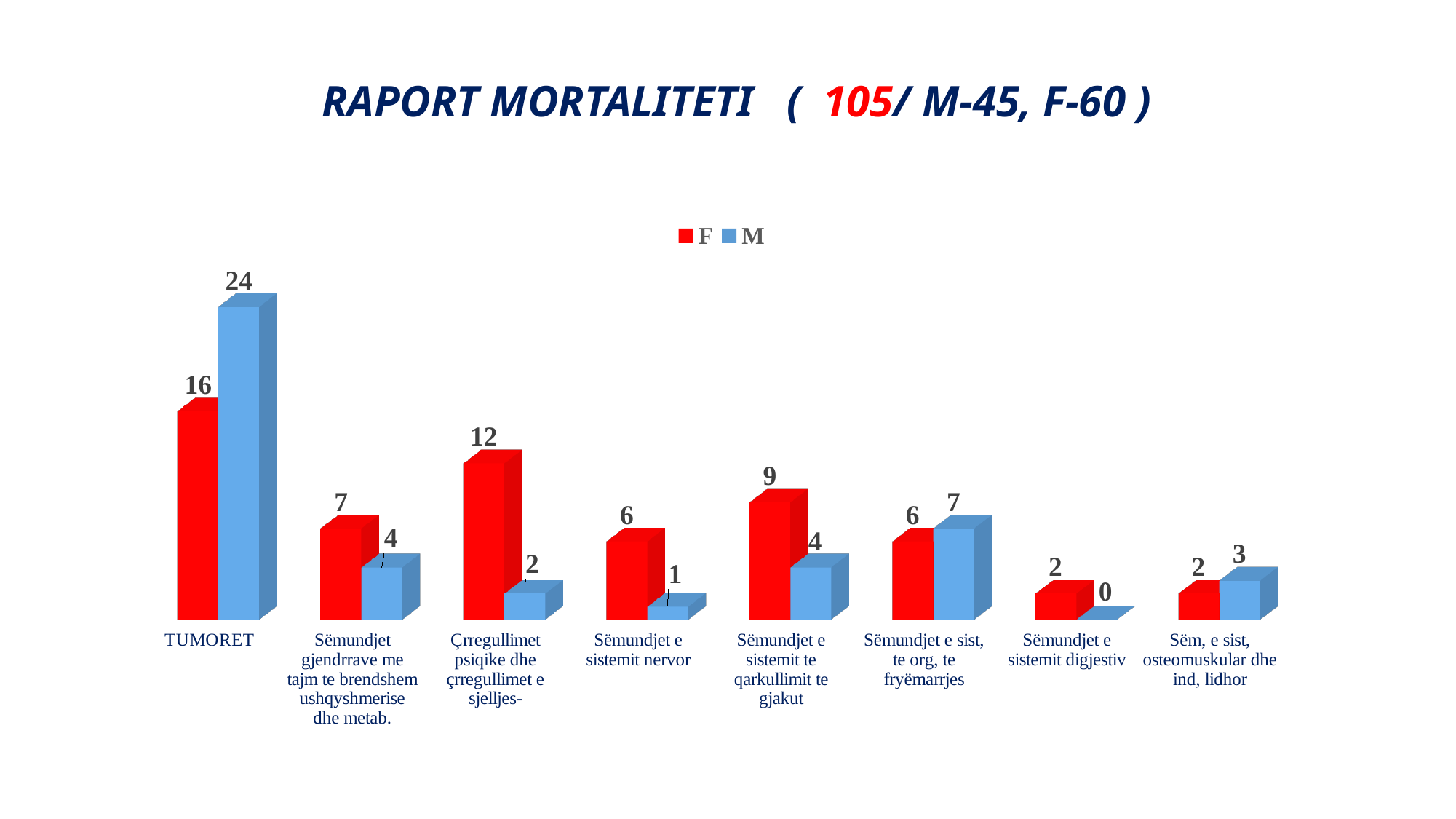
What is the M value for Sëmundjet e sistemit digjestiv? 0 What is the F value for TUMORET? 16 What is the difference between the M and F values for TUMORET? 8 What kind of chart is shown on the slide? bar chart Which colour represents the F series? red What is the F value for Çrregullimet psiqike dhe çrregullimet e sjelljes? 12 How many categories are shown on the x axis? 8 Which is larger for Sëmundjet e sist, te org, te fryëmarrjes: the F value or the M value? M Which category has the lowest M value? Sëmundjet e sistemit digjestiv What is the M value for TUMORET? 24 Which category has the highest M value? TUMORET How many series does the legend list? 2